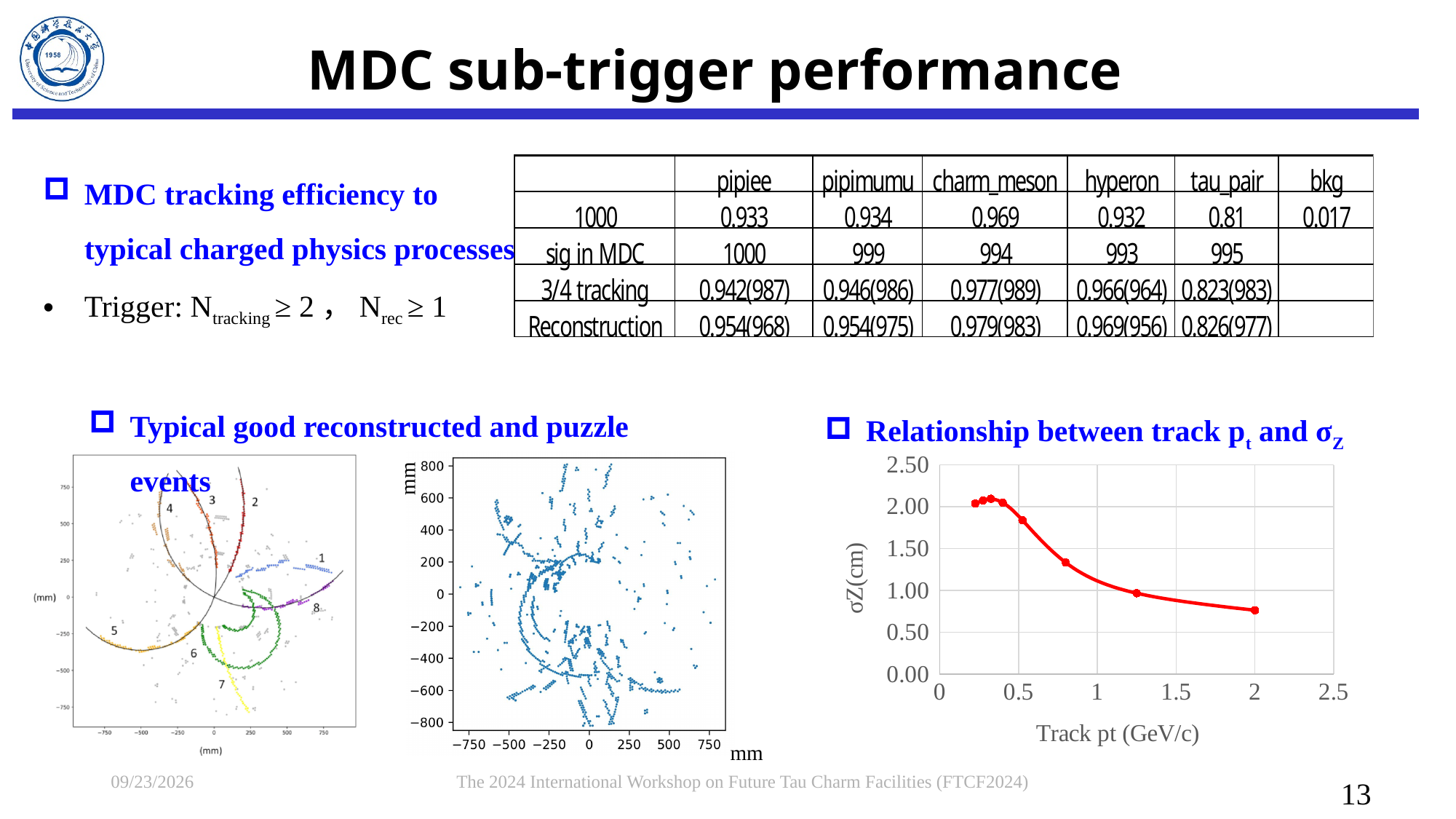
What is the x-axis label of the 'Relationship between track pt and σz' chart? Track pt (GeV/c) In the 'Relationship between track pt and σz' chart, is the σZ value at track pt 1.25 GeV/c greater or less than 1.50 cm? less In the 'Relationship between track pt and σz' chart, does σZ rise or fall as track pt increases from 0.5 to 2 GeV/c? fall In the 'Relationship between track pt and σz' chart, at which track pt value is σZ lowest? 2 GeV/c In the 'Relationship between track pt and σz' chart, is the σZ value at track pt 0.5 GeV/c greater or less than 1.50 cm? greater In the 'Relationship between track pt and σz' chart, is the σZ value at track pt 0.8 GeV/c greater or less than 1.00 cm? greater What is the y-axis label of the 'Relationship between track pt and σz' chart? σZ(cm) In the 'Relationship between track pt and σz' chart, which has the larger σZ: the point at track pt 0.5 GeV/c or the point at track pt 2 GeV/c? track pt 0.5 GeV/c What kind of chart is the 'Relationship between track pt and σz' chart? line chart